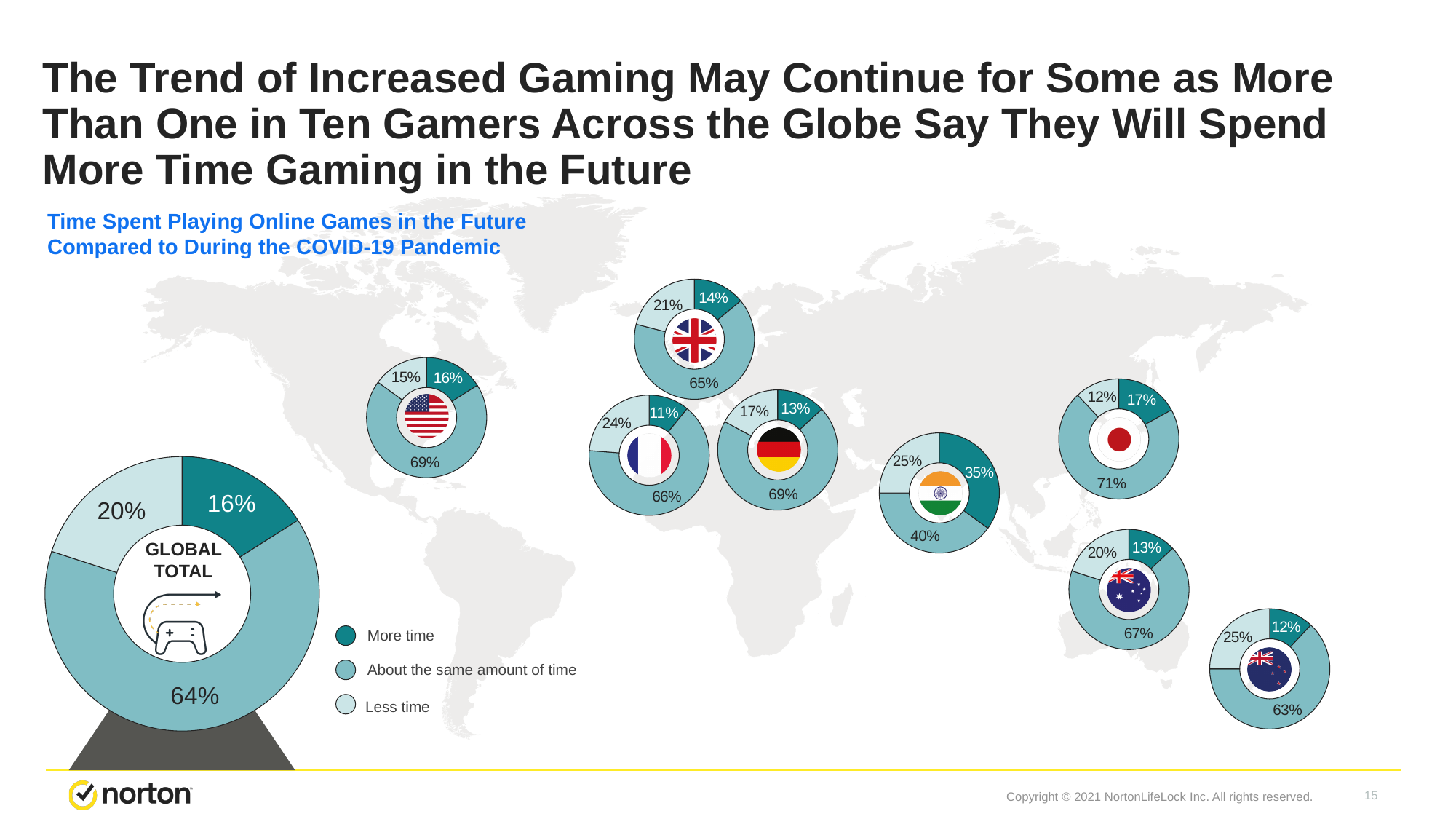
In the Global Total chart, what percentage of gamers say they will spend more time gaming in the future? 16% What kind of chart is used to show the Global Total? Donut (pie) chart What is the title of the chart section shown in blue text? Time Spent Playing Online Games in the Future Compared to During the COVID-19 Pandemic How many series does the legend list? 3 In the Global Total chart, what percentage say they will spend about the same amount of time? 64% In the chart with the France flag, what percentage say they will spend less time gaming? 24% In the chart with the India flag, what percentage say they will spend more time gaming? 35% Across the country charts, which country's chart shows the lowest share for 'More time'? France In the chart with the Japan flag, what percentage say they will spend about the same amount of time? 71% In the Global Total chart, what is the difference between the 'Less time' share and the 'More time' share? 4% Which is larger: the 'More time' share in the chart with the Japan flag or in the chart with the United Kingdom flag? Japan Across the country charts, which country's chart shows the highest share for 'More time'? India